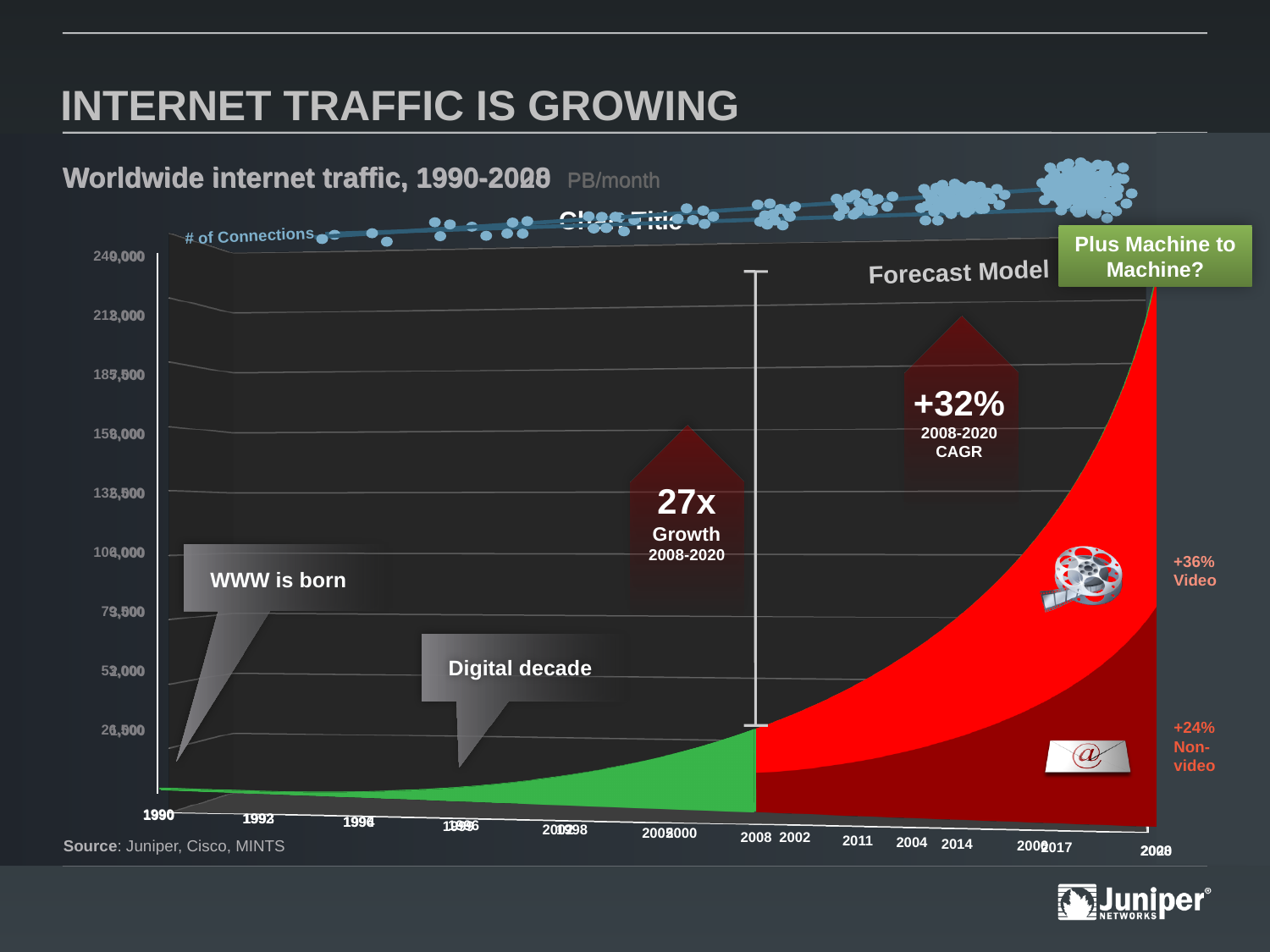
What is the 2008-2020 CAGR shown on the chart? +32% What kind of chart is used to show worldwide internet traffic? area chart What growth rate is shown for Non-video on the chart? +24% What unit is the worldwide internet traffic measured in? PB/month What is the difference between the Video and Non-video growth rates shown? 12% Which has the higher annotated growth rate, Video or Non-video? Video How much growth does the chart annotate for 2008-2020? 27x Does worldwide internet traffic rise or fall from 1990 to 2020 on the chart? rise What sources are cited for the chart? Juniper, Cisco, MINTS What growth rate is shown for Video on the chart? +36%